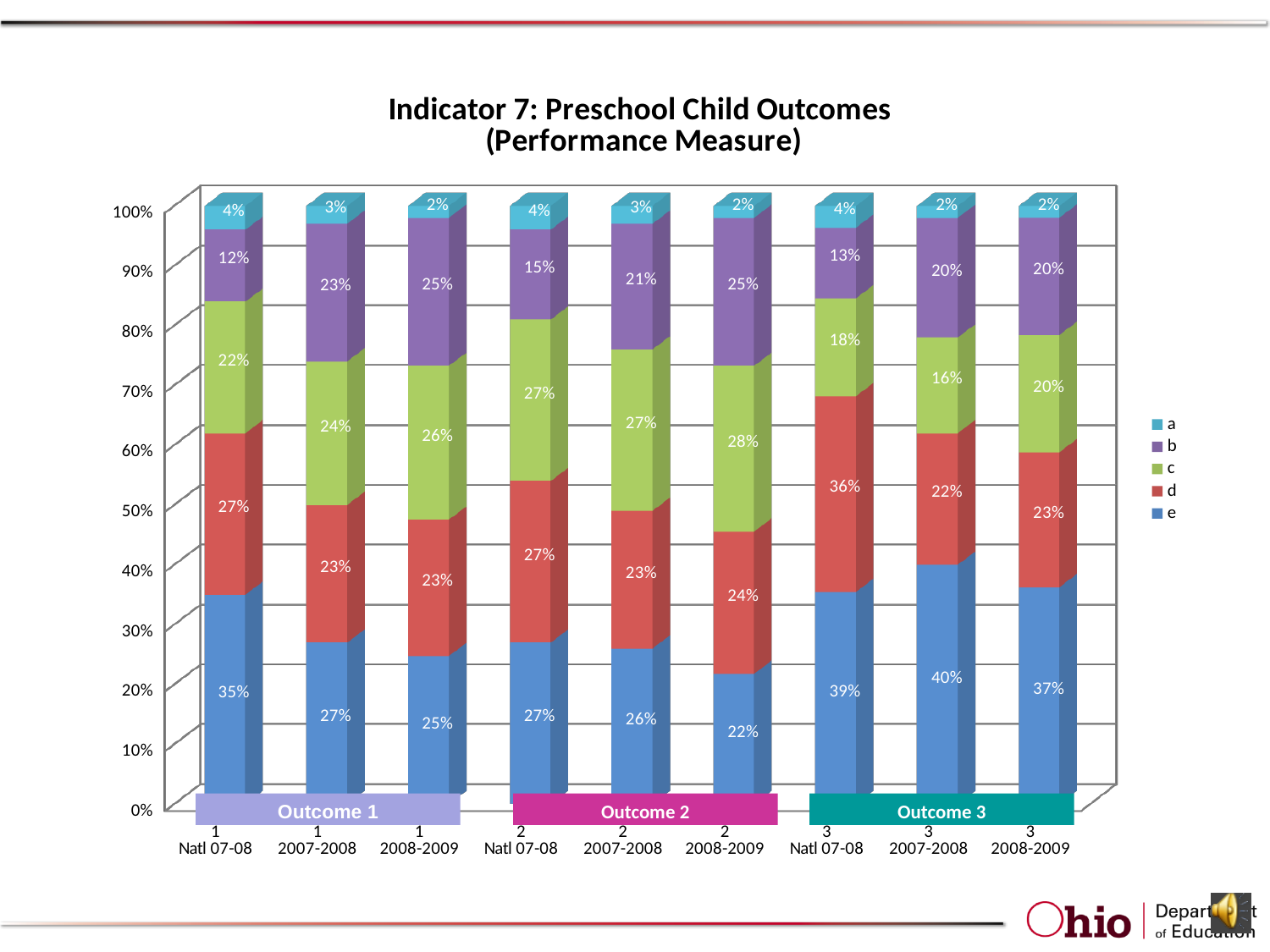
What is the value of series d for the '3 Natl 07-08' bar? 36% Which bar has the lowest value for series e? 2 2008-2009 What is the value of series c for the '2 2008-2009' bar? 28% What type of chart is shown on the slide? stacked bar chart What is the difference between the series e values for '1 Natl 07-08' and '1 2008-2009'? 10% What is the value of series e for the '1 Natl 07-08' bar? 35% What is the value of series b for the '3 2007-2008' bar? 20% How many series does the legend list? 5 What is the title of the chart? Indicator 7: Preschool Child Outcomes (Performance Measure) How many bars (categories) are plotted in the chart? 9 Which bar has the highest value for series e? 3 2007-2008 Which is larger: series c for '2 Natl 07-08' or series c for '3 2007-2008'? 2 Natl 07-08